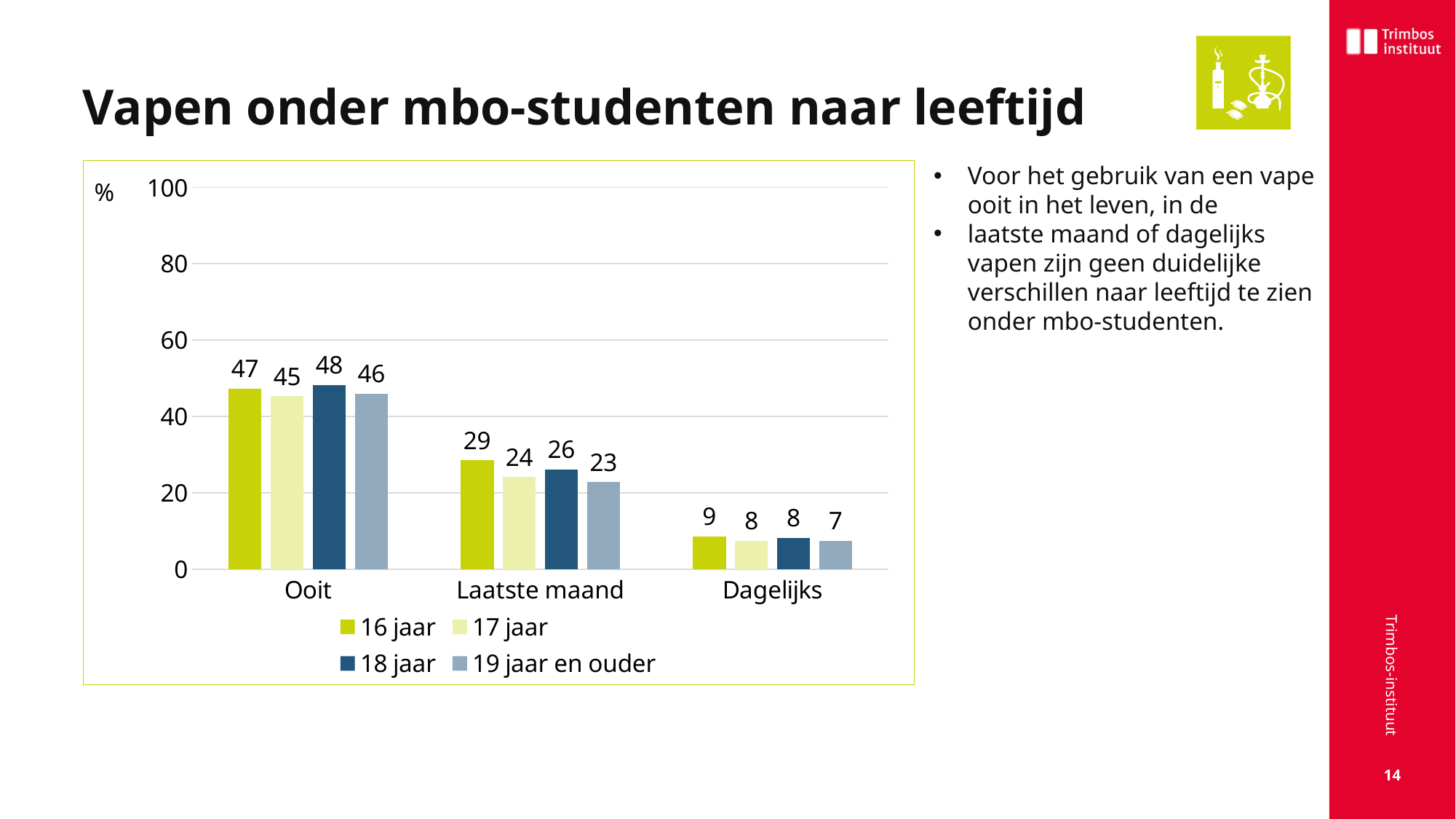
How many categories are shown on the x axis? 3 What is the value for 17 jaar in the Dagelijks category? 8 Do the values for 16 jaar rise or fall from Ooit to Dagelijks? Fall Which age group has the highest value in the Ooit category? 18 jaar How many series does the legend list? 4 Which is larger in the Ooit category: the value for 17 jaar or the value for 19 jaar en ouder? 19 jaar en ouder Which age group has the lowest value in the Laatste maand category? 19 jaar en ouder What is the value for 19 jaar en ouder in the Laatste maand category? 23 What kind of chart is shown on the slide? Bar chart What is the value for 16 jaar in the Ooit category? 47 Is the value for 18 jaar in the Ooit category greater or less than 40? greater What is the difference between the 16 jaar and 17 jaar values in the Laatste maand category? 5